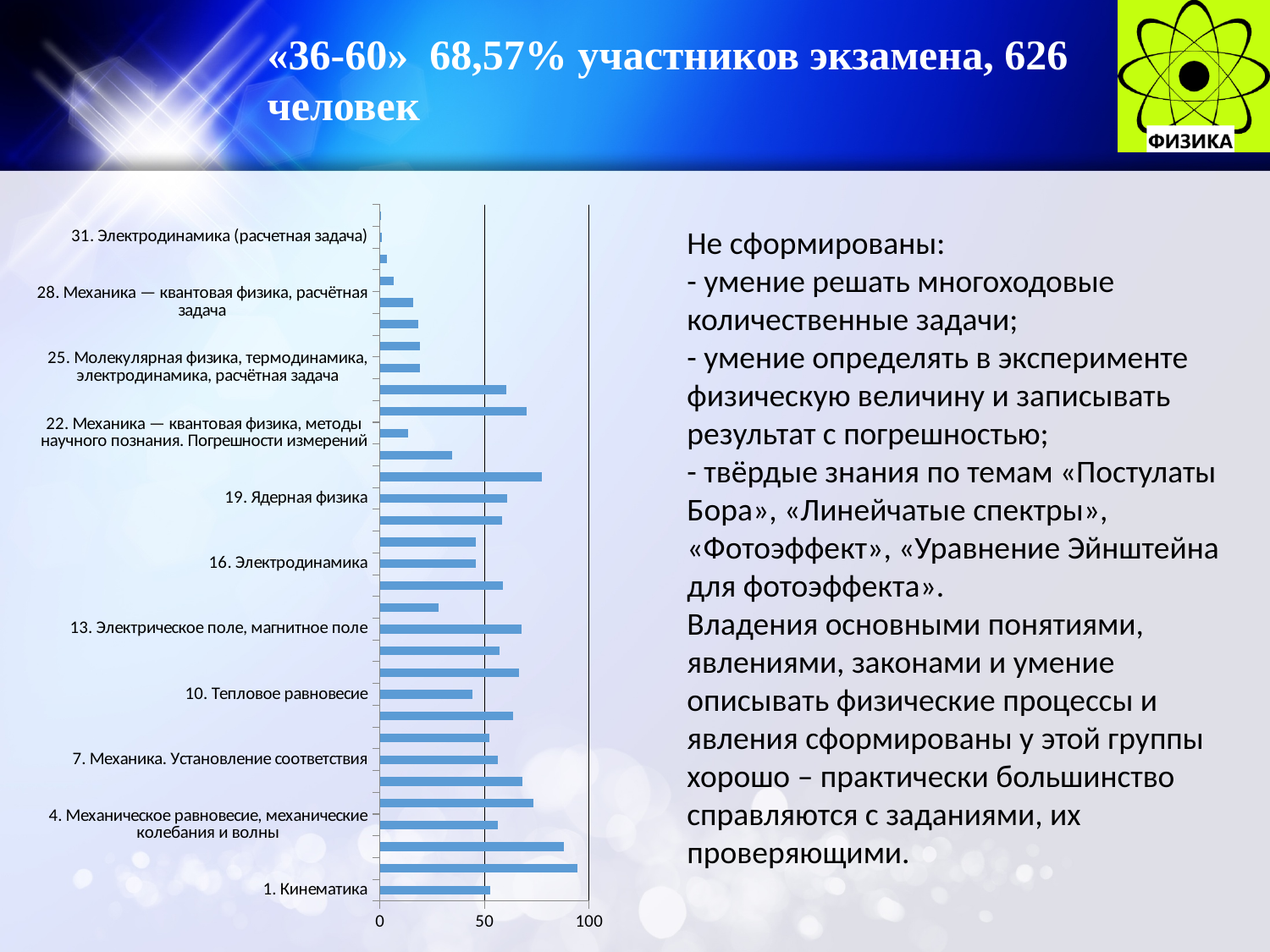
What is the maximum value shown on the horizontal axis of the chart? 100 Is the value for "13. Электрическое поле, магнитное поле" greater or less than 50? greater Is the value for "25. Молекулярная физика, термодинамика, электродинамика, расчётная задача" greater or less than 50? less Which labelled category has the lowest value in the chart? 31. Электродинамика (расчетная задача) What kind of chart is shown on the slide? bar chart Which has the larger value: "13. Электрическое поле, магнитное поле" or "22. Механика — квантовая физика, методы научного познания. Погрешности измерений"? 13. Электрическое поле, магнитное поле Is the value for "19. Ядерная физика" greater or less than 50? greater Which has the larger value: "19. Ядерная физика" or "25. Молекулярная физика, термодинамика, электродинамика, расчётная задача"? 19. Ядерная физика Which has the larger value: "4. Механическое равновесие, механические колебания и волны" or "31. Электродинамика (расчетная задача)"? 4. Механическое равновесие, механические колебания и волны